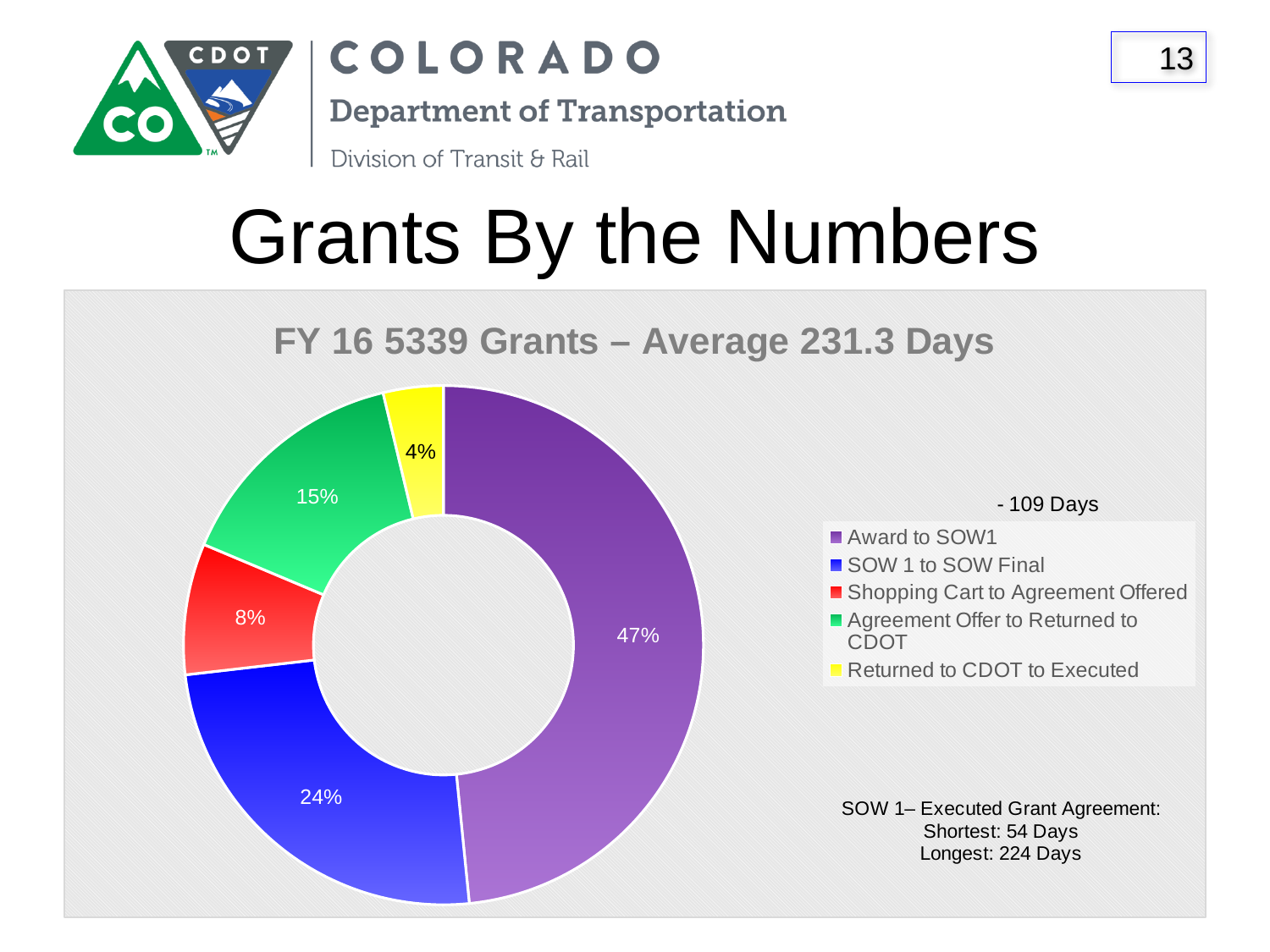
What share of the chart does Shopping Cart to Agreement Offered represent? 8% What share of the chart does Award to SOW1 represent? 47% Which category has the largest share of the chart? Award to SOW1 What share of the chart does Returned to CDOT to Executed represent? 4% Which is larger, the share for Agreement Offer to Returned to CDOT or the share for Shopping Cart to Agreement Offered? Agreement Offer to Returned to CDOT How many categories does the chart show? 5 What kind of chart is shown on the slide? Doughnut chart What is the title of the chart? FY 16 5339 Grants – Average 231.3 Days What share of the chart does Agreement Offer to Returned to CDOT represent? 15% What share of the chart does SOW 1 to SOW Final represent? 24% Which category has the smallest share of the chart? Returned to CDOT to Executed What is the difference in percentage points between Award to SOW1 and SOW 1 to SOW Final? 23